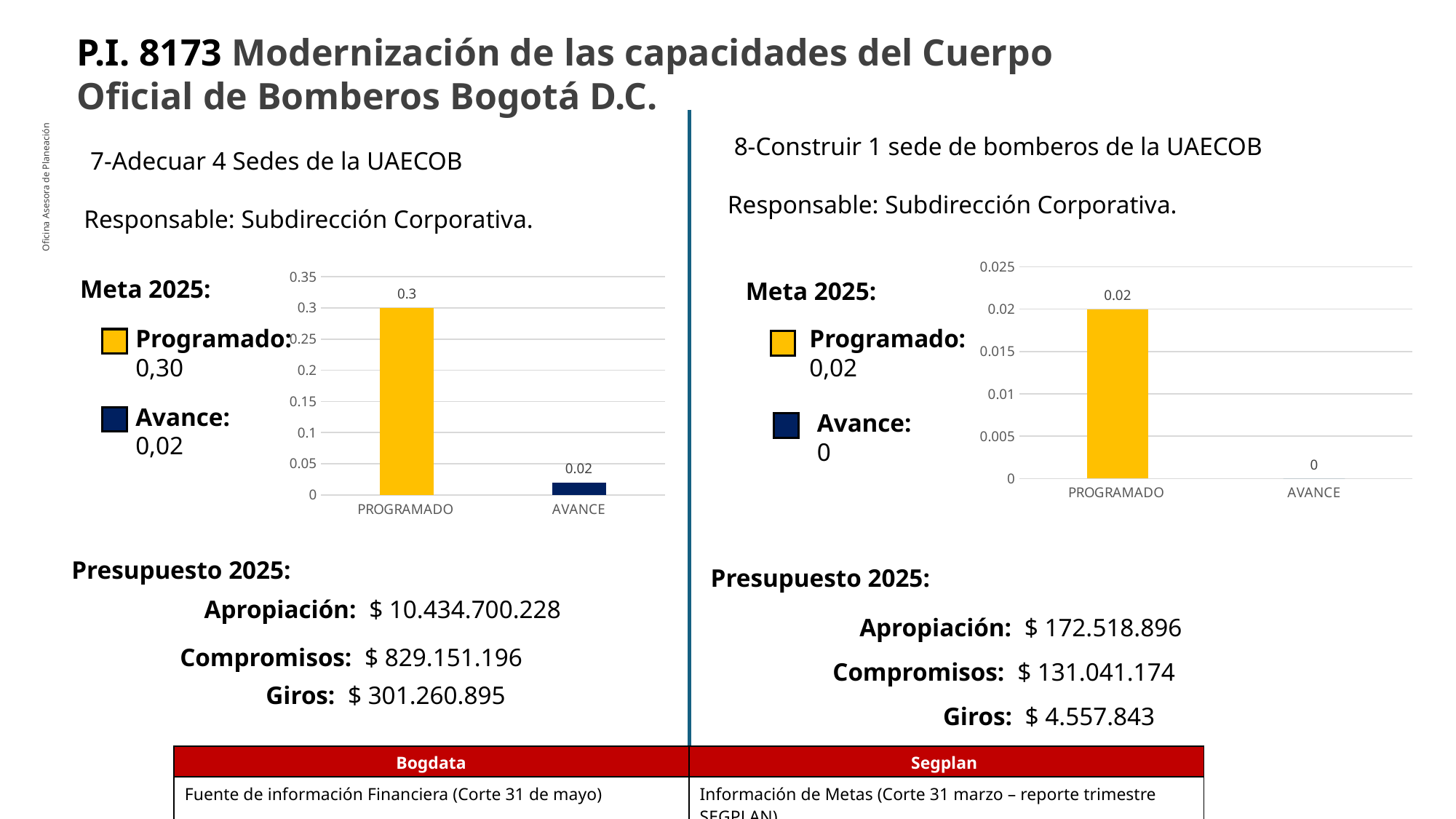
In the left chart, which is larger, PROGRAMADO or AVANCE? PROGRAMADO In the right chart (8-Construir 1 sede de bomberos de la UAECOB), what is the value of the AVANCE bar? 0 In the right chart, what is the difference between the PROGRAMADO and AVANCE values? 0.02 In the left chart (7-Adecuar 4 Sedes de la UAECOB), what is the value of the AVANCE bar? 0.02 In the right chart (8-Construir 1 sede de bomberos de la UAECOB), what is the value of the PROGRAMADO bar? 0.02 In the right chart, which category has the lowest value? AVANCE In the left chart, which category has the highest value? PROGRAMADO What type of chart is the right chart? Bar chart How many categories are shown on the x axis of the left chart? 2 In the left chart, what colour is the PROGRAMADO bar? Yellow In the left chart, what is the difference between the PROGRAMADO and AVANCE values? 0.28 In the left chart (7-Adecuar 4 Sedes de la UAECOB), what is the value of the PROGRAMADO bar? 0.3